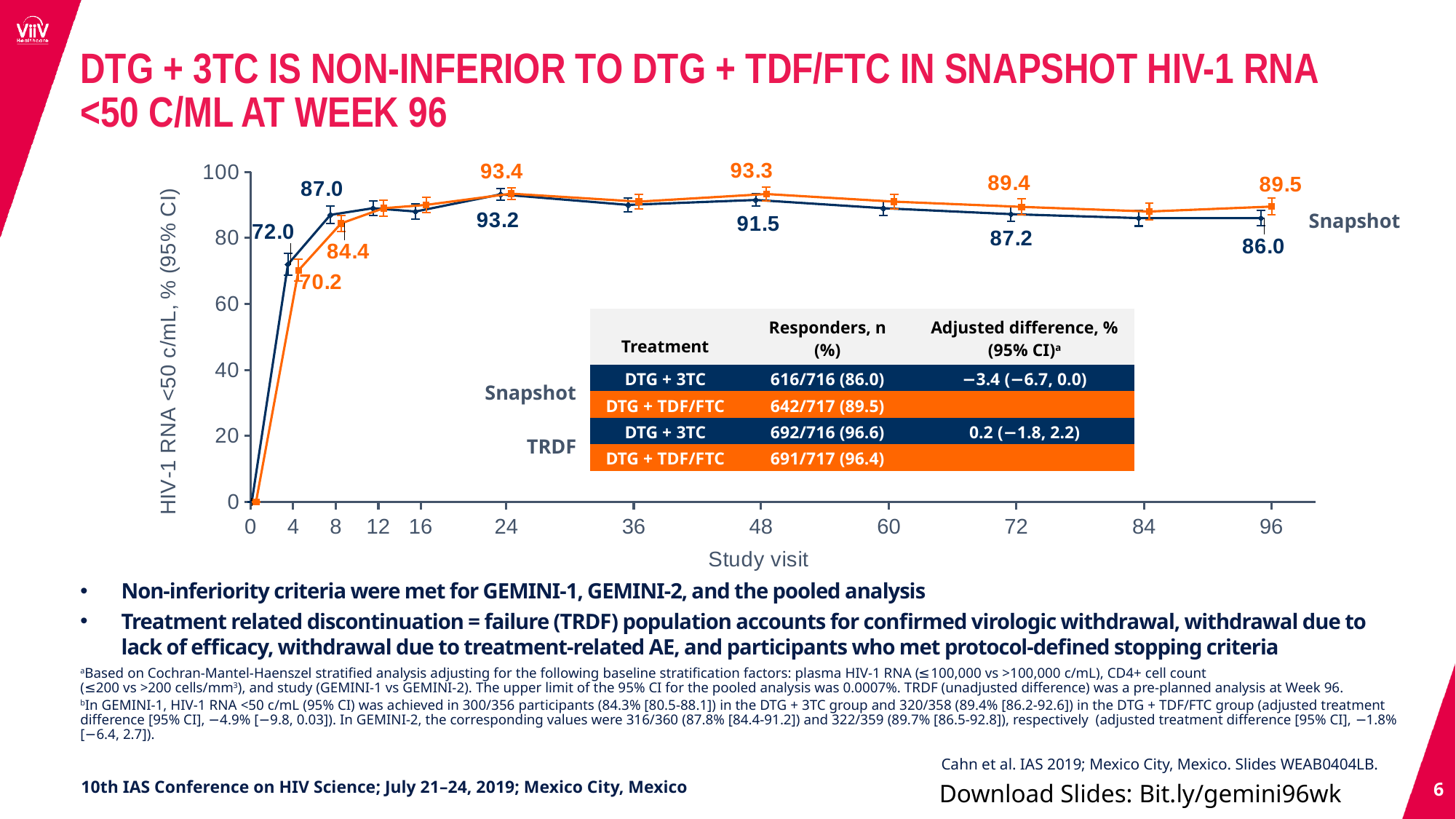
At week 48, which line has the higher value, the dark blue DTG + 3TC line or the orange DTG + TDF/FTC line? orange DTG + TDF/FTC What is the value for the orange DTG + TDF/FTC line at week 96? 89.5 What is the value for the dark blue DTG + 3TC line at week 4? 72.0 How many study visits are marked on the x axis? 12 What is the value for the orange DTG + TDF/FTC line at week 48? 93.3 Is the value for the dark blue DTG + 3TC line at week 12 greater or less than 80? greater What is the difference between the dark blue DTG + 3TC value and the orange DTG + TDF/FTC value at week 8? 2.6 Does the dark blue DTG + 3TC line rise or fall from week 48 to week 96? fall What is the difference between the orange DTG + TDF/FTC value and the dark blue DTG + 3TC value at week 96? 3.5 What is the value for the dark blue DTG + 3TC line at week 96? 86.0 What kind of chart is shown on the slide? line chart At which study visit does the orange DTG + TDF/FTC line reach its highest labelled value? 24